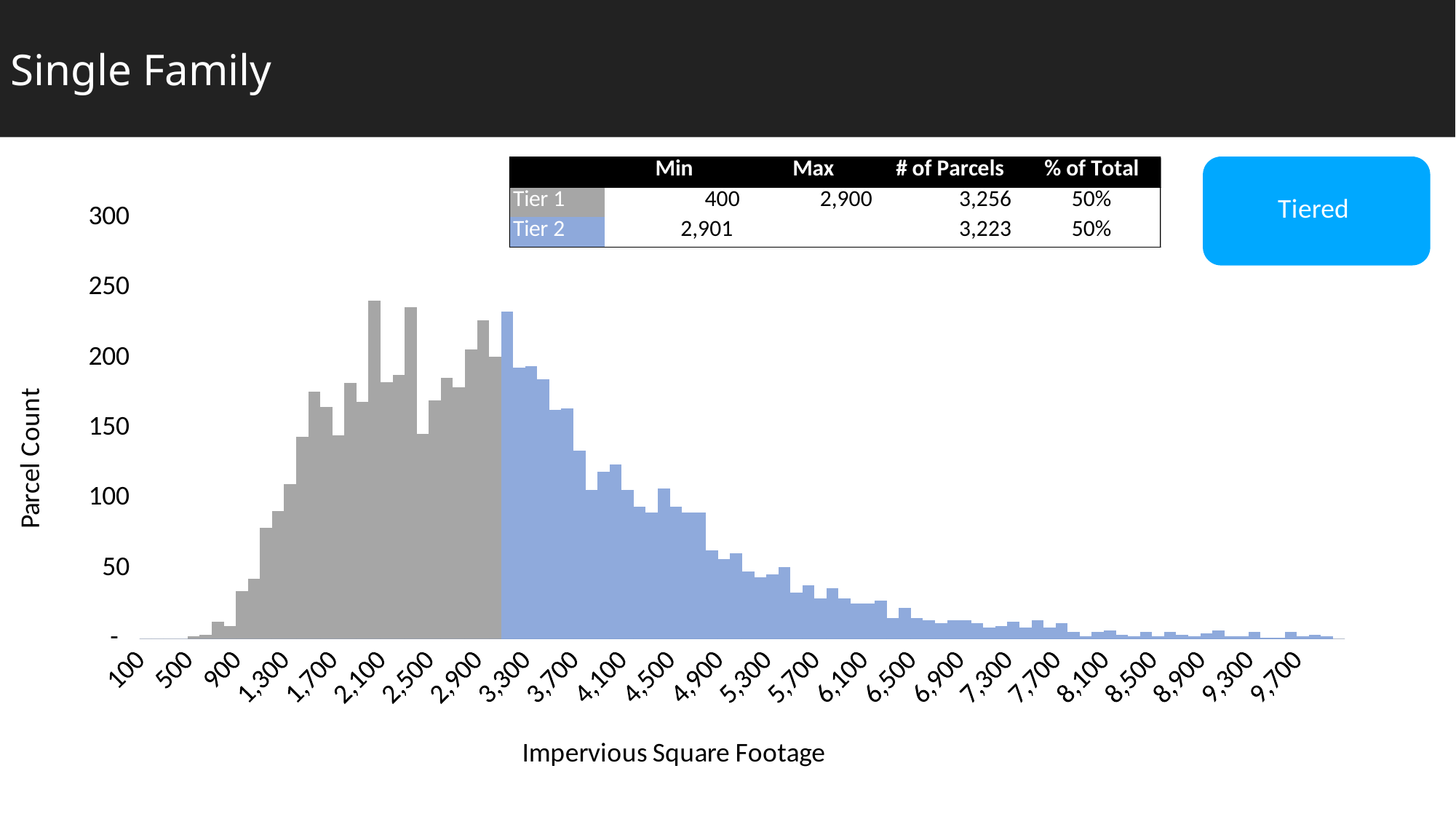
How many labelled tick marks are on the x axis of the chart? 25 Which has the larger parcel count, 1,700 square feet or 5,300 square feet? 1,700 Do the parcel counts rise or fall along the x axis from 3,300 to 9,700 square feet? fall What is the title of the x axis of the chart? Impervious Square Footage What is the title of the y axis of the chart? Parcel Count What kind of chart is shown on the slide? bar chart Is the parcel count at 1,700 square feet greater or less than 100? greater Is the parcel count at 7,700 square feet greater or less than 50? less Is the parcel count at 900 square feet greater or less than 50? less